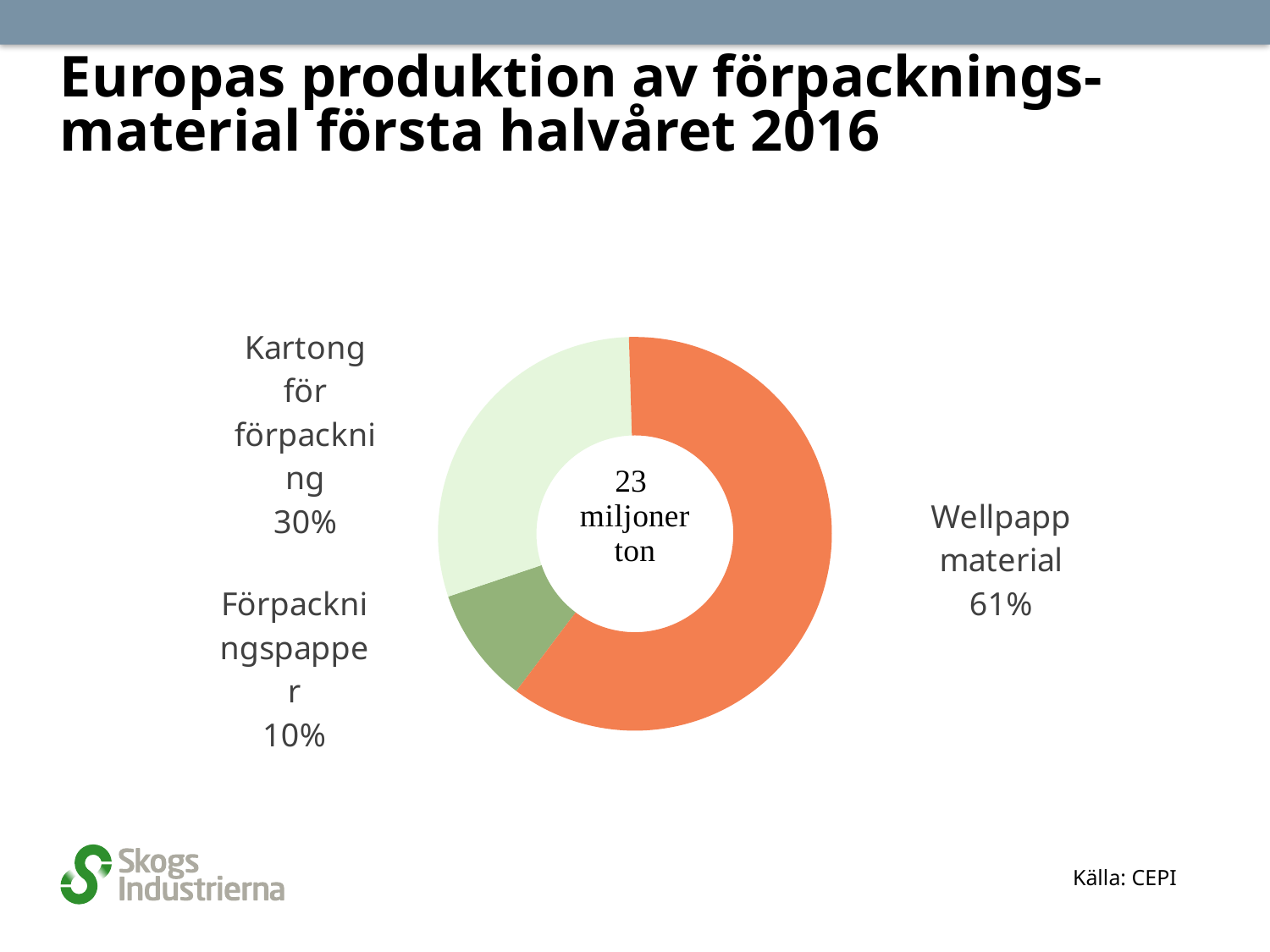
What share of the chart does Wellpapp material represent? 61% What colour is the Wellpapp material segment? Orange How many categories are shown in the chart? 3 Which category has the smallest share of the chart? Förpackningspapper How many percentage points larger is the share of Kartong för förpackning than that of Förpackningspapper? 20 How many percentage points larger is the share of Wellpapp material than that of Kartong för förpackning? 31 Which category has the largest share of the chart? Wellpapp material Which has a larger share, Kartong för förpackning or Förpackningspapper? Kartong för förpackning What share of the chart does Förpackningspapper represent? 10% What total quantity is printed in the centre of the chart? 23 miljoner ton What share of the chart does Kartong för förpackning represent? 30% What kind of chart is shown on the slide? Doughnut (pie) chart